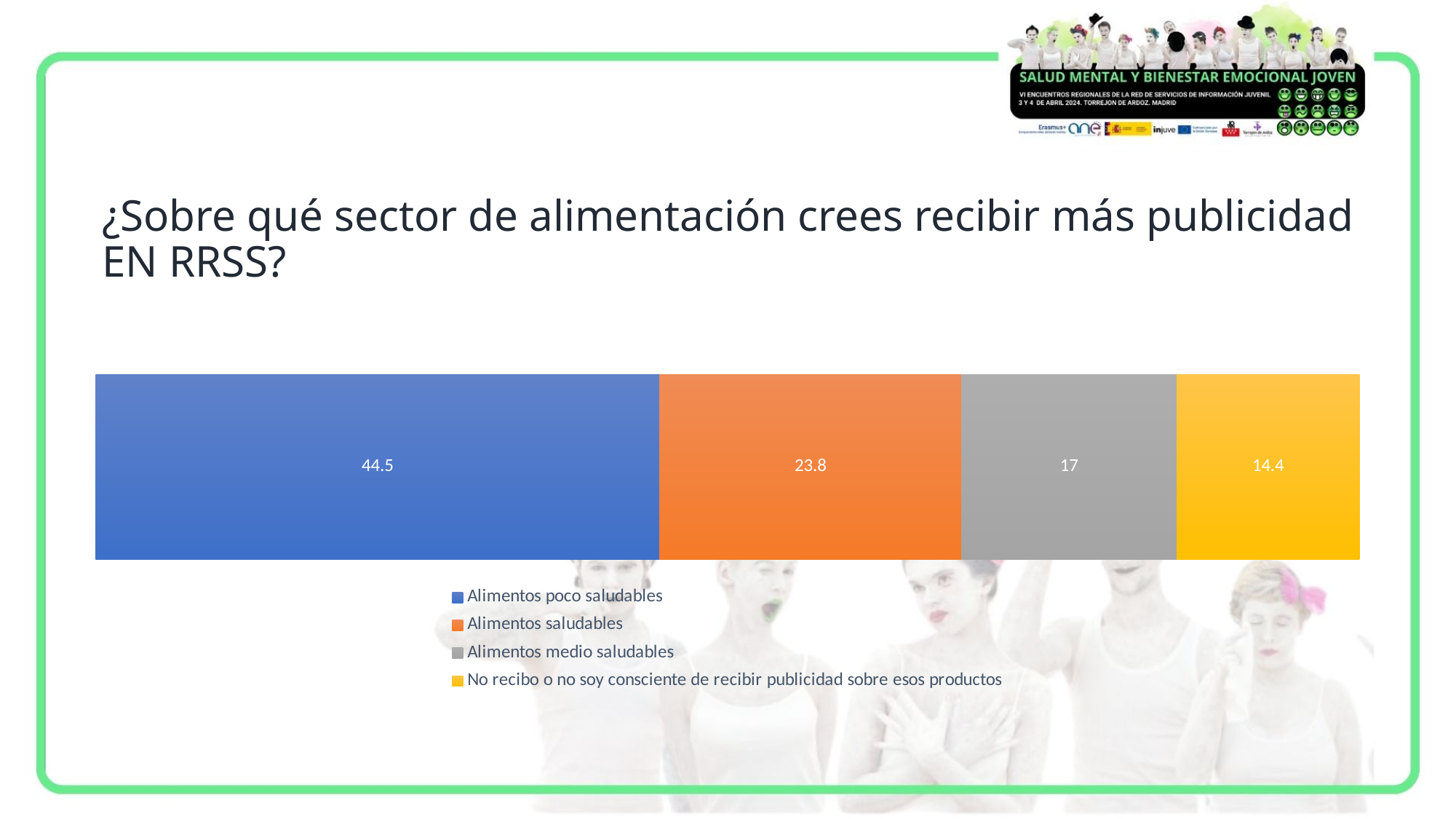
What is the value for Alimentos poco saludables? 44.5 What is the value for Alimentos saludables? 23.8 What is the value for 'No recibo o no soy consciente de recibir publicidad sobre esos productos'? 14.4 Which category has the lowest value? No recibo o no soy consciente de recibir publicidad sobre esos productos What kind of chart is shown on the slide? Stacked bar chart Which category has the highest value? Alimentos poco saludables What is the difference between the values for Alimentos poco saludables and Alimentos saludables? 20.7 What colour is the segment for Alimentos medio saludables? Grey Which is larger, the value for Alimentos medio saludables or the value for Alimentos saludables? Alimentos saludables What is the total of the stacked bar? 99.7 How many series does the legend list? 4 What is the value for Alimentos medio saludables? 17